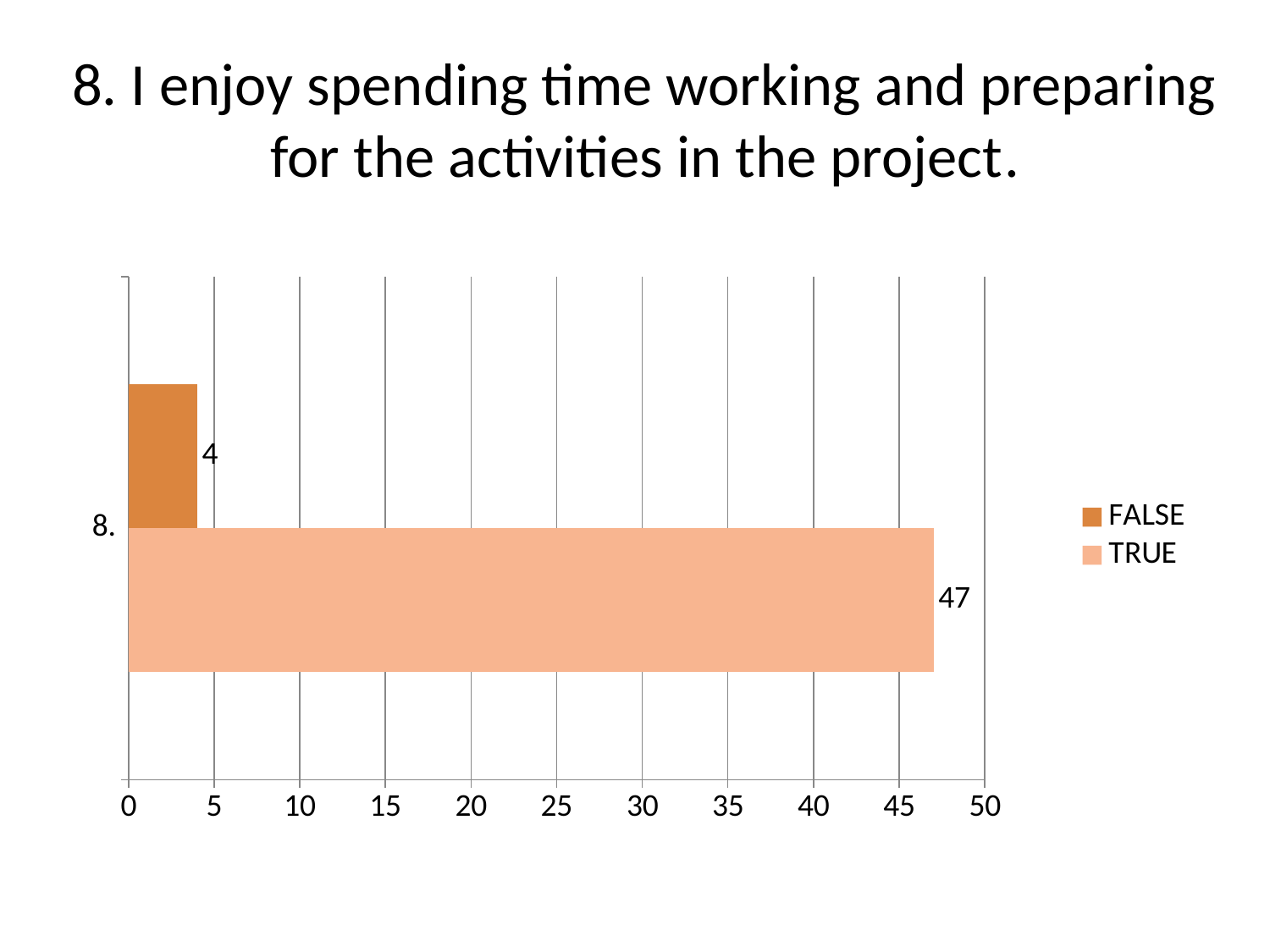
Is the value for FALSE greater or less than 5? less What is the value for TRUE? 47 How many series does the legend list? 2 What kind of chart is shown on the slide? bar chart Is the value for TRUE greater or less than 45? greater Which series has the higher value, TRUE or FALSE? TRUE What is the difference between the TRUE and FALSE values? 43 What is the value for FALSE? 4 What is the category label on the y axis? 8. What is the highest value shown on the x axis? 50 What is the total of the TRUE and FALSE values? 51 Which series has the lowest value? FALSE